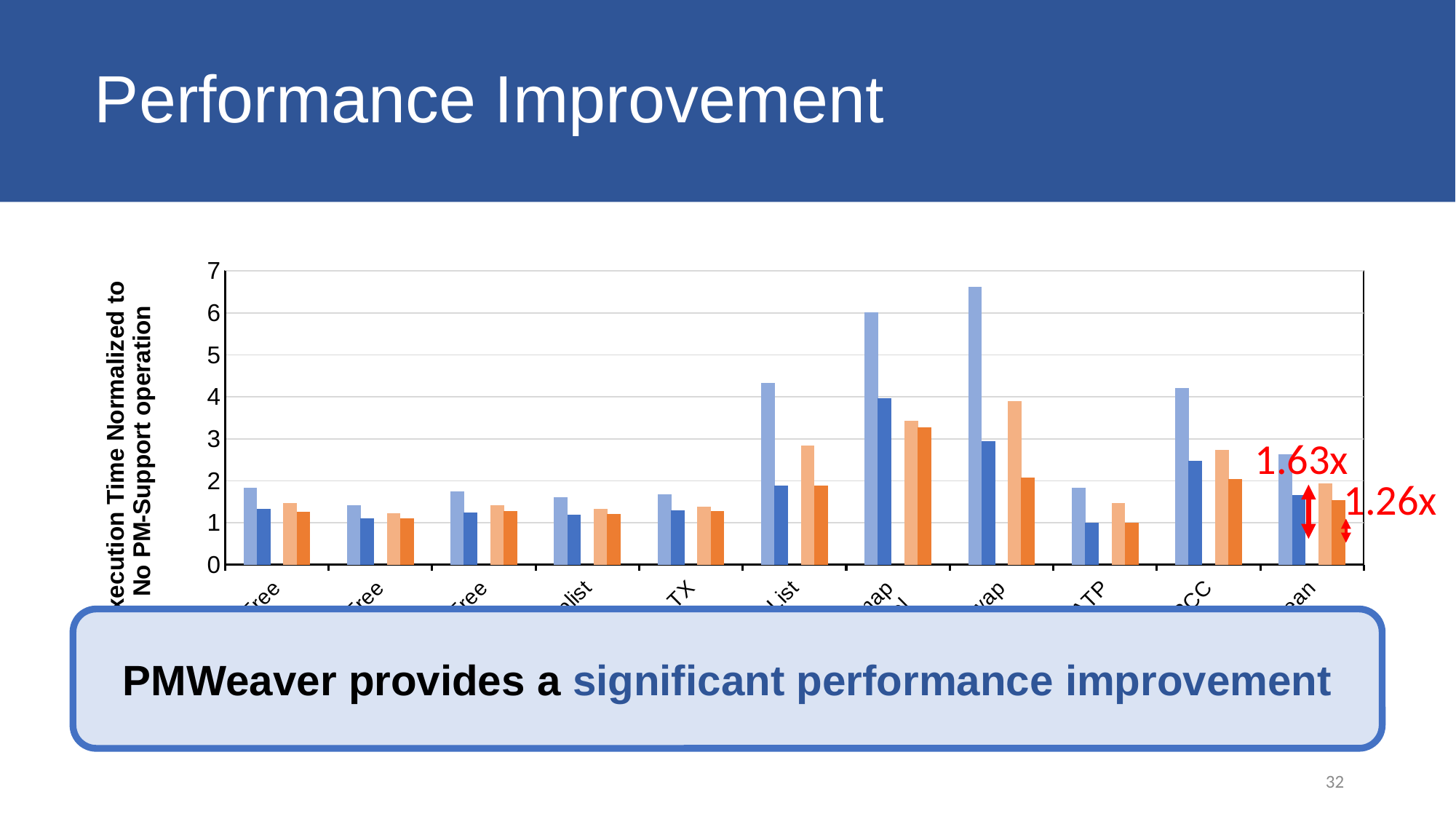
How many groups of bars are plotted along the x axis? 11 Which group of bars, counting from the left, contains the tallest bar in the chart? the eighth group What is the highest value shown on the y axis? 7 Is the light blue bar in the rightmost group greater or less than 2? greater In the eighth group from the left, which is taller: the light orange bar or the dark orange bar? the light orange bar Is the light blue bar in the seventh group from the left greater or less than 5? greater How many bars are there in each group along the x axis? 4 Is the dark orange bar in the rightmost group greater or less than 2? less What kind of chart is shown on the slide? bar chart What two red annotations are written next to the rightmost group of bars? 1.63x and 1.26x In the rightmost group, which is taller: the light blue bar or the dark blue bar? the light blue bar